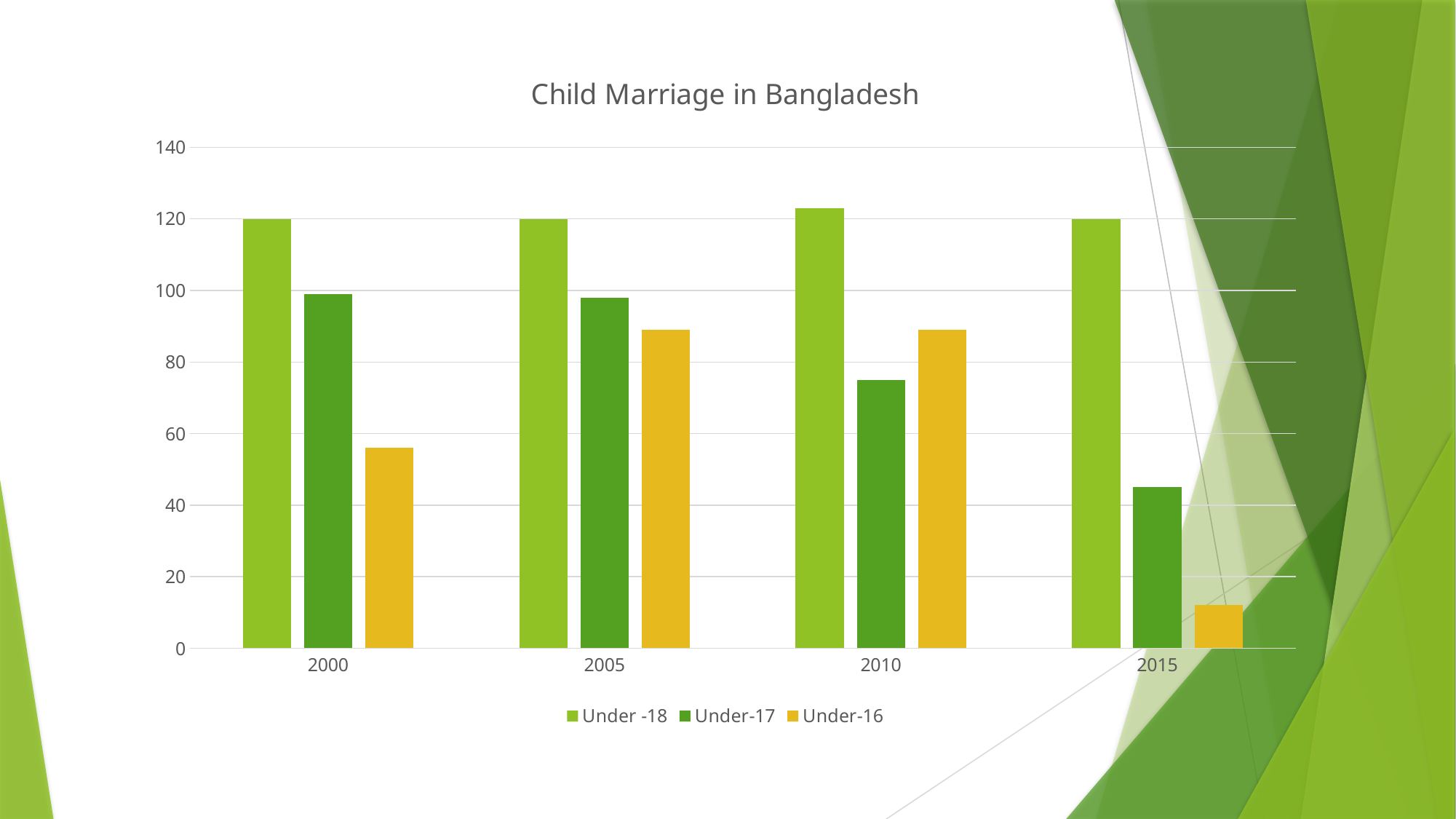
What is the title of the chart? Child Marriage in Bangladesh Is the value for Under-17 in 2010 greater or less than 80? less Is the value for Under-16 in 2005 greater or less than 80? greater Do the Under-17 values rise or fall from 2000 to 2015? fall How many year categories are shown on the x axis? 4 How many series does the legend list? 3 In which year is the Under-17 value lowest? 2015 In which year is the Under-16 value lowest? 2015 What kind of chart is shown on the slide? bar chart Is the value for Under-16 in 2000 greater or less than 60? less Which series is shown in yellow in the legend? Under-16